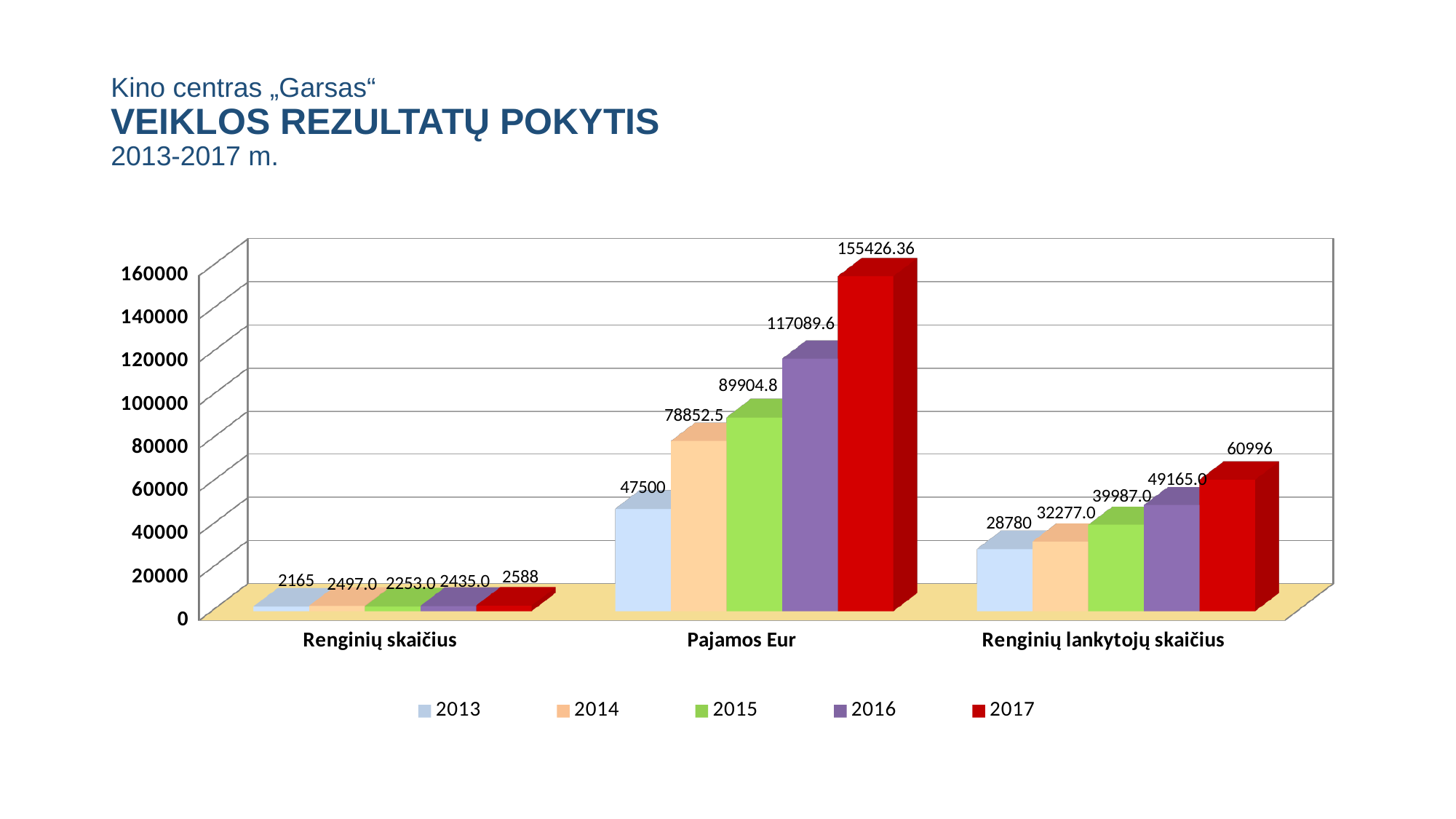
How many series does the legend list? 5 What is the value for 2013 in the Renginių lankytojų skaičius category? 28780 Do the values in the Pajamos Eur category rise or fall from 2013 to 2017? rise Which year has the highest value in the Pajamos Eur category? 2017 Which year has the lowest value in the Renginių skaičius category? 2013 Is the value for 2016 in the Pajamos Eur category greater or less than 100000? greater What kind of chart is shown on the slide? bar chart What is the difference between the 2017 and 2016 values in the Renginių lankytojų skaičius category? 11831 Which is larger in the Renginių skaičius category: the value for 2014 or the value for 2015? 2014 What is the value for 2014 in the Renginių skaičius category? 2497.0 How many categories are shown on the x axis? 3 What is the value for 2017 in the Pajamos Eur category? 155426.36